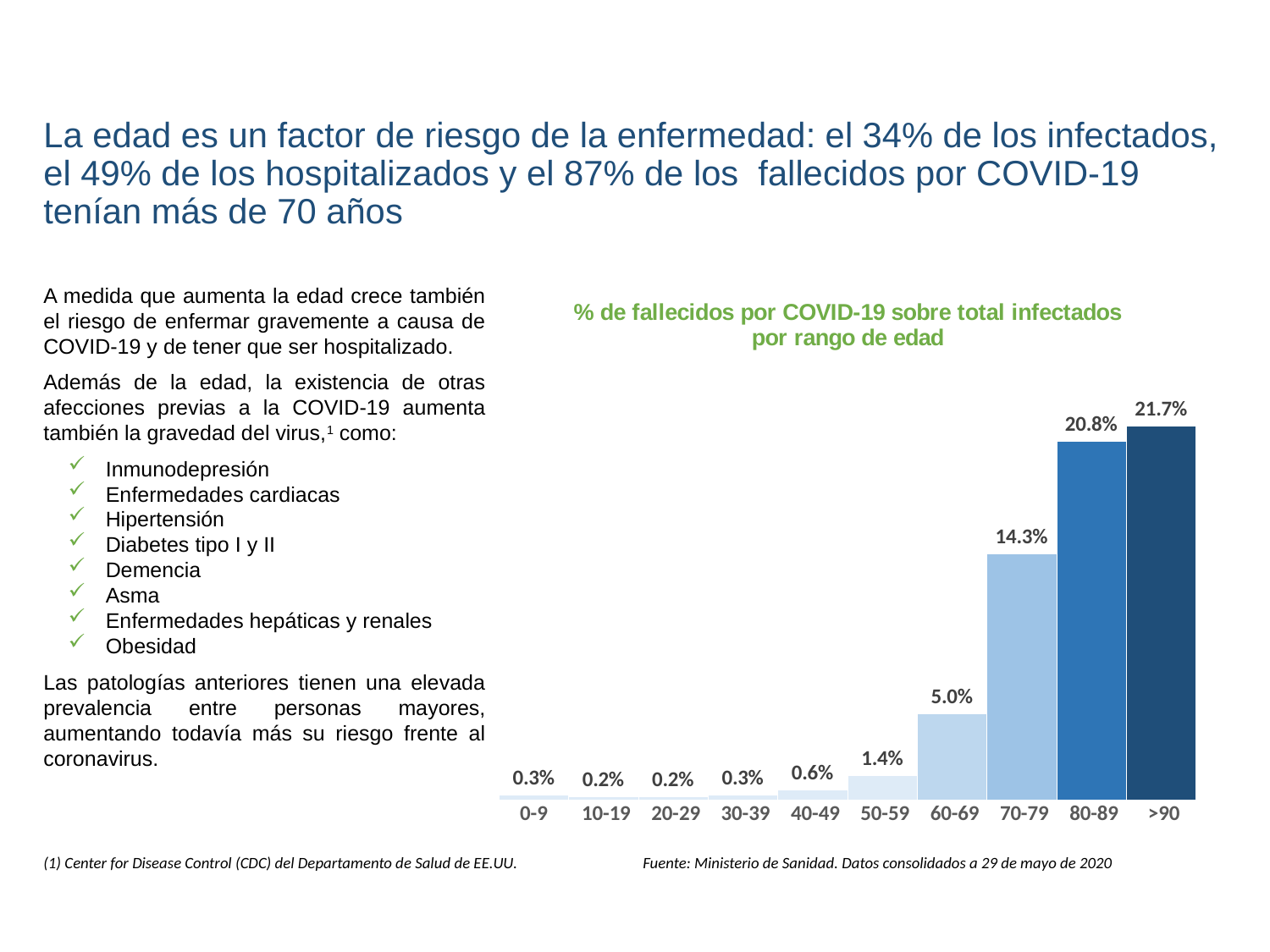
What is the value for the 70-79 age range? 14.3% Which is larger, the value for 60-69 or the value for 50-59? 60-69 Do the values rise or fall as age increases from 30-39 to >90? rise What is the title of the chart? % de fallecidos por COVID-19 sobre total infectados por rango de edad What is the value for the 50-59 age range? 1.4% What is the value for the 40-49 age range? 0.6% Which age range has the highest value? >90 How many age ranges are shown on the x axis? 10 What is the difference between the values for >90 and 80-89? 0.9% What is the value for the 60-69 age range? 5.0% What kind of chart is shown? bar chart What is the difference between the values for 80-89 and 70-79? 6.5%